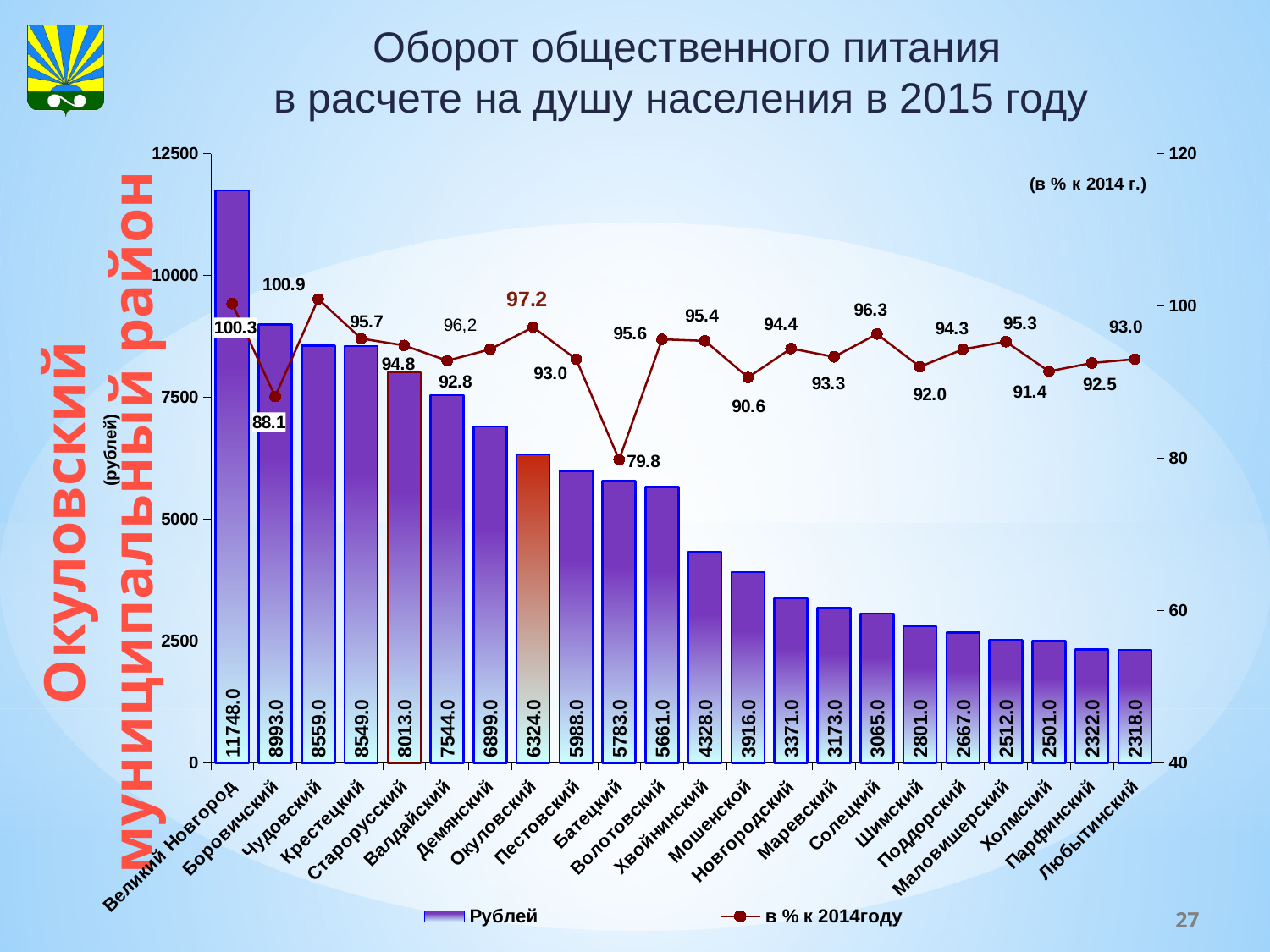
What is the value in rubles for Окуловский? 6324.0 What is the difference in rubles between Боровичский and Чудовский? 434.0 Which has a higher value in rubles, Демянский or Пестовский? Демянский How many categories are shown on the x axis? 22 What kind of chart is this? Combined bar and line chart Do the bar values rise or fall from left to right along the x axis? Fall How many series does the legend list? 2 What is the percentage relative to 2014 for Батецкий? 79.8 Which category has the lowest percentage relative to 2014? Батецкий What is the value in rubles for Великий Новгород? 11748.0 Which category has the highest value in rubles? Великий Новгород What is the percentage relative to 2014 for Чудовский? 100.9